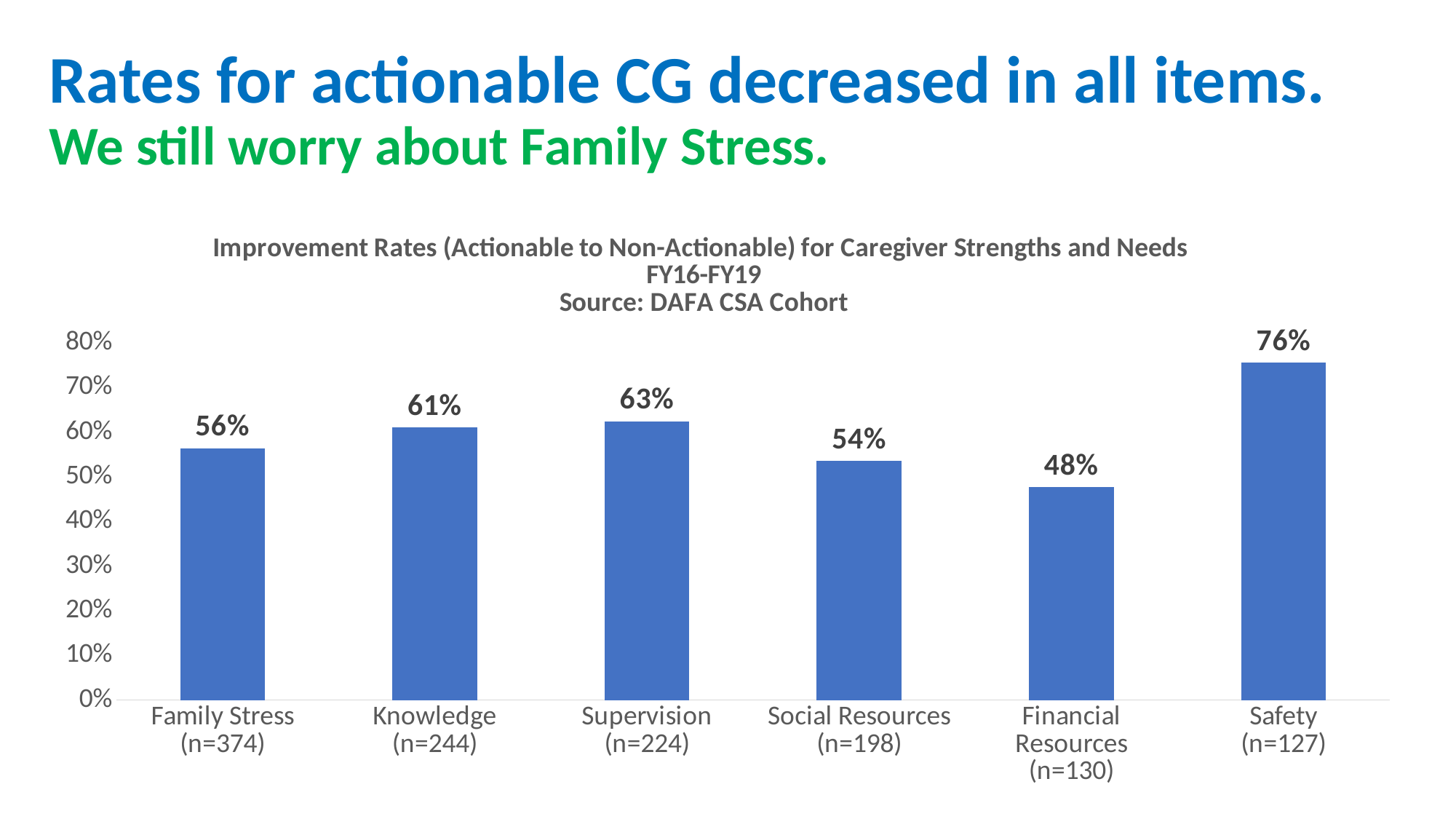
What kind of chart is shown on the slide? Bar chart What is the improvement rate for Supervision? 63% Is the value for Social Resources greater or less than 60%? less What is the difference between the improvement rates for Safety and Family Stress? 20% Which has a higher improvement rate, Knowledge or Social Resources? Knowledge What is the improvement rate for Financial Resources? 48% How many categories are shown in the chart? 6 Which category has the lowest improvement rate? Financial Resources What source is cited in the chart title? DAFA CSA Cohort What is the sample size (n) shown for Family Stress? 374 Which category has the highest improvement rate? Safety What is the improvement rate for Family Stress? 56%